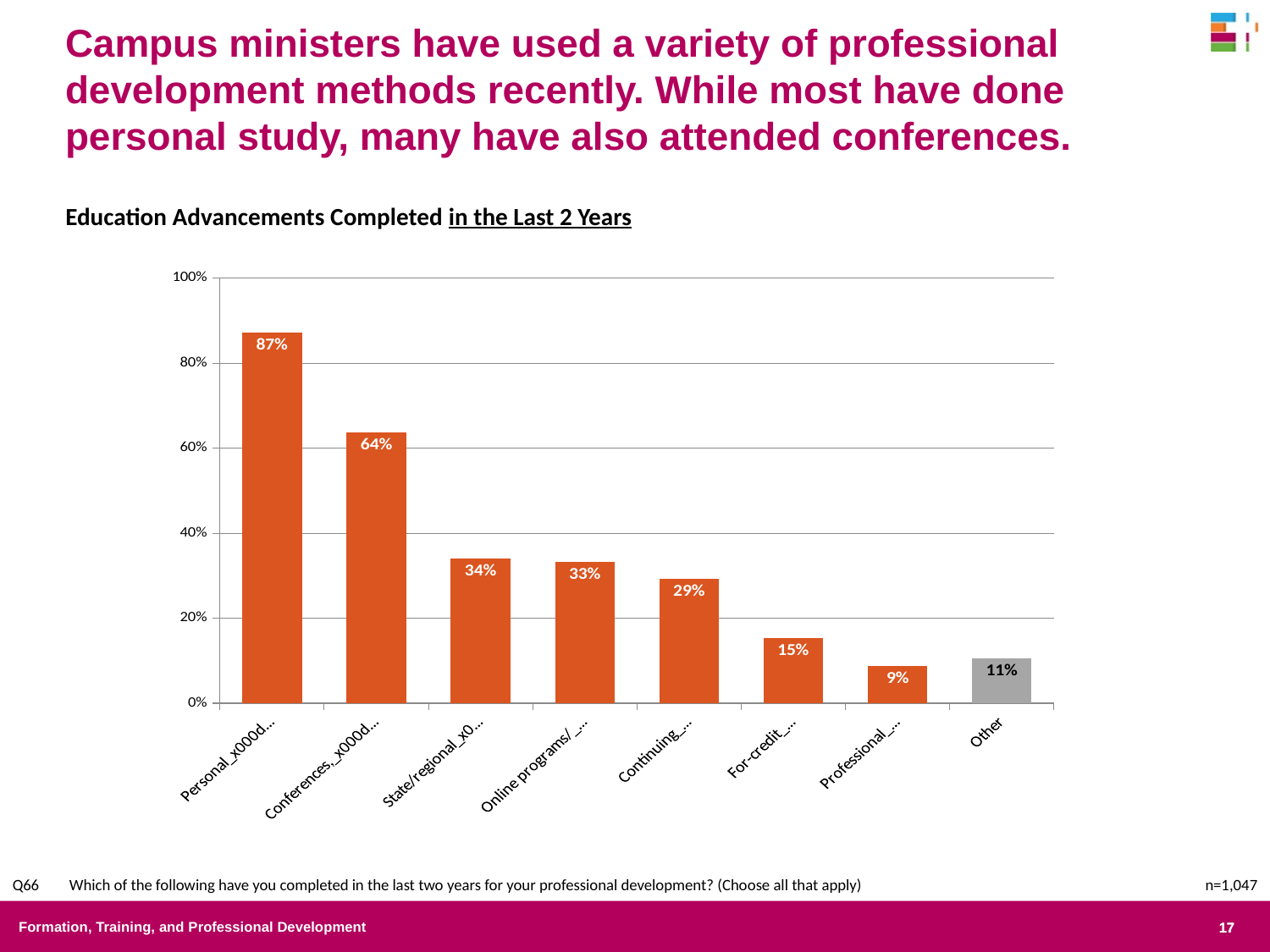
How many categories (bars) are shown in the chart? 8 Which category has the lowest value in the chart? Professional Which is larger, the value for Continuing or the value for For-credit? Continuing What value is shown for the Other category? 11% What percentage of campus ministers completed Personal study in the last 2 years? 87% What is the value shown for the Conferences bar? 64% What is the difference in percentage points between the Personal bar and the Conferences bar? 23 percentage points Which bar in the chart is coloured grey rather than orange? Other Is the value for Conferences greater or less than 60%? greater What is the value for the For-credit bar? 15% What type of chart is shown on the slide? Bar chart Which category has the highest value in the chart? Personal